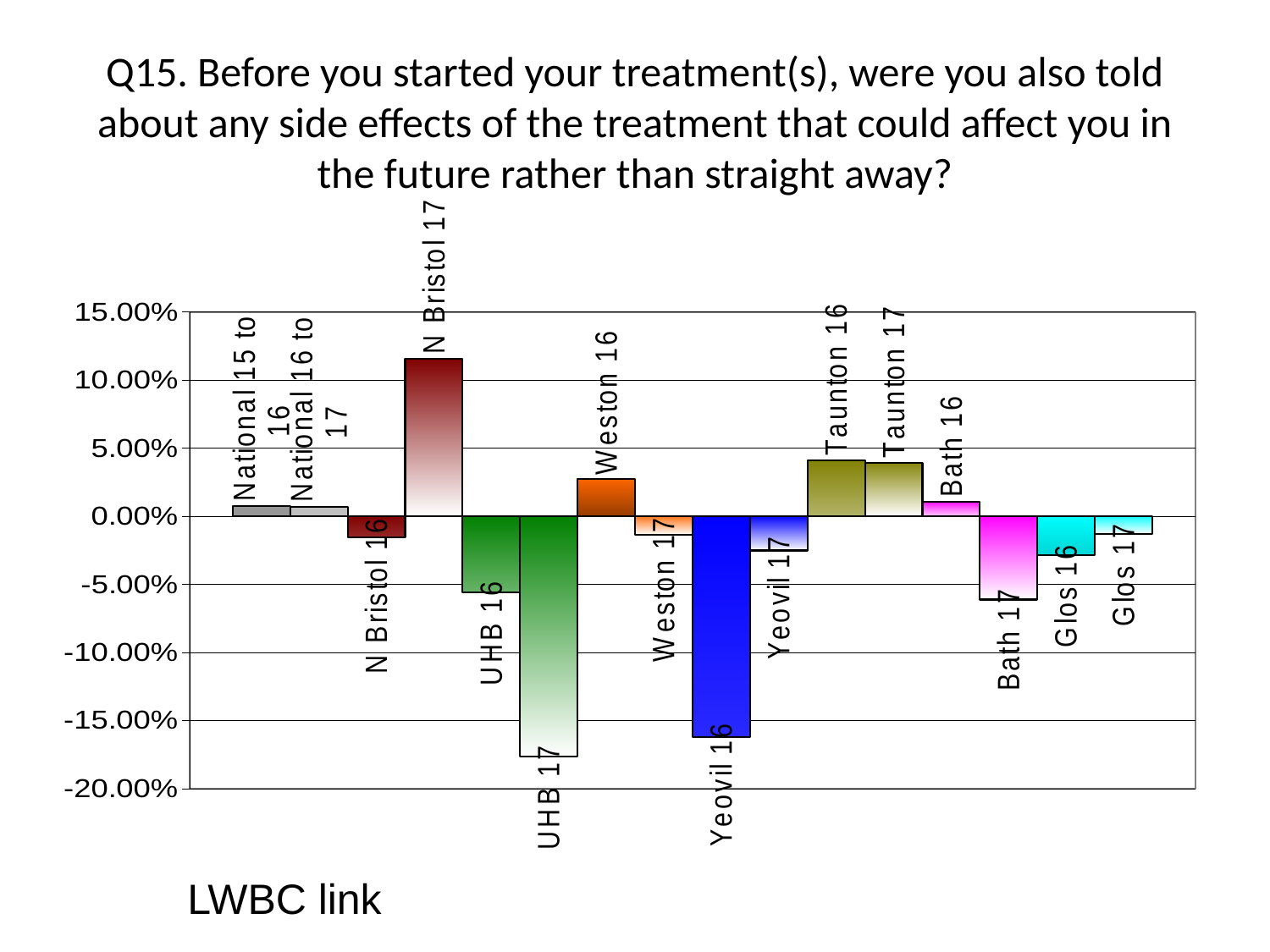
Which category has the lowest value in the chart? UHB 17 Which is larger, the value for Weston 16 or the value for Weston 17? Weston 16 How many bars (categories) are plotted in the chart? 16 What question number is referenced in the chart's title? Q15 Is the value for Bath 17 greater or less than -5.00%? less Is the value for Taunton 16 greater or less than 5.00%? less Which is larger, the value for Taunton 16 or the value for Bath 16? Taunton 16 Is the value for N Bristol 17 greater or less than 10.00%? greater What kind of chart is shown on the slide? bar chart Which category has the highest value in the chart? N Bristol 17